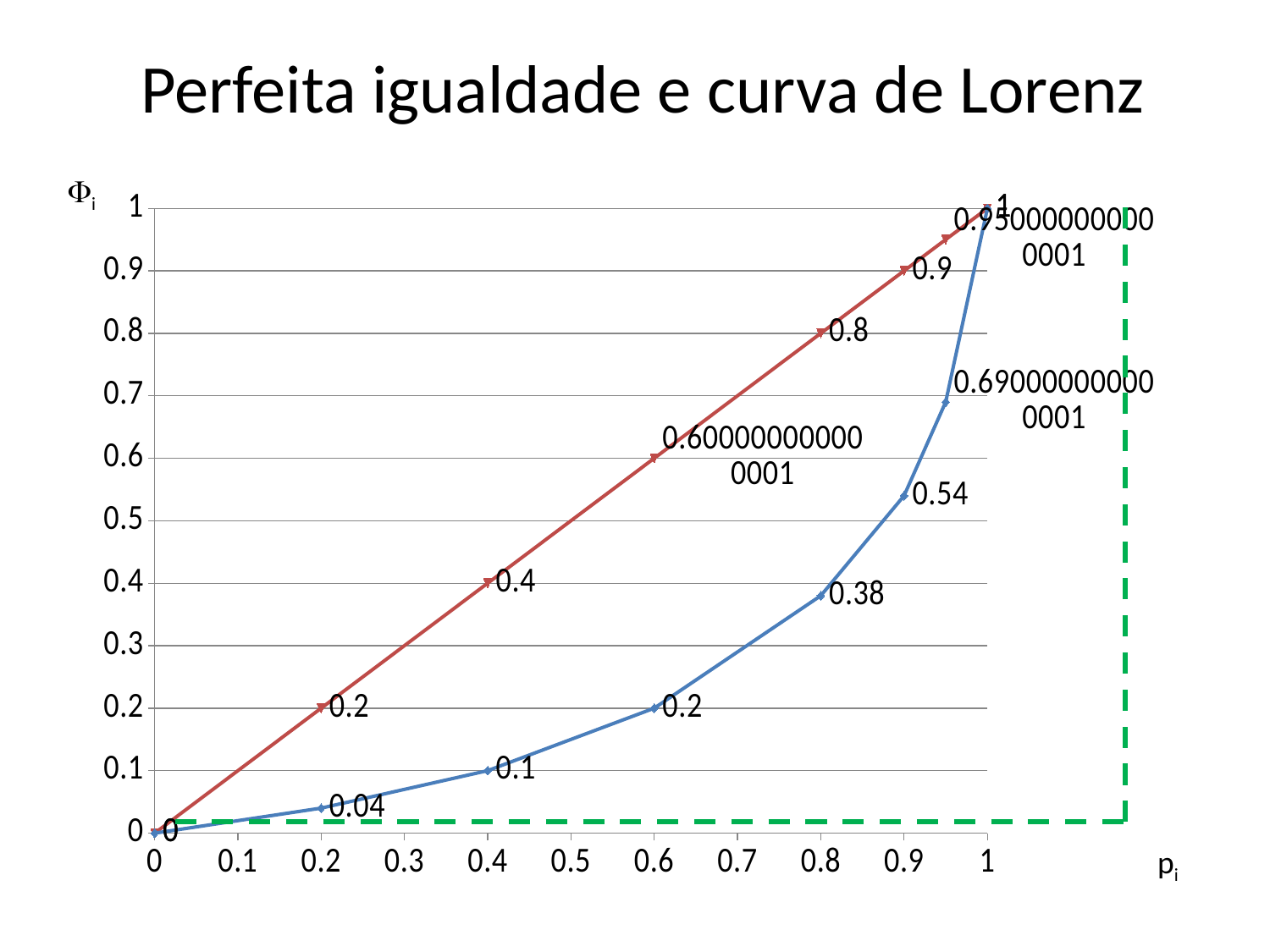
What is the value of the blue (lower) curve at p_i = 0.8? 0.38 What is the value of the red (upper) line at p_i = 0.4? 0.4 What is the value of the blue (lower) curve at p_i = 0.2? 0.04 At p_i = 0.6, which is larger: the red line or the blue curve? the red line Do the values of the blue curve rise or fall as p_i increases? rise What is the value of the blue (lower) curve at p_i = 0.4? 0.1 What is the difference between the red line and the blue curve at p_i = 0.8? 0.42 What kind of chart is shown on the slide? line chart How many data points are plotted on the blue curve? 8 What is the title of the chart? Perfeita igualdade e curva de Lorenz What is the value of the blue (lower) curve at p_i = 0.9? 0.54 What is the difference between the red line and the blue curve at p_i = 0.4? 0.3